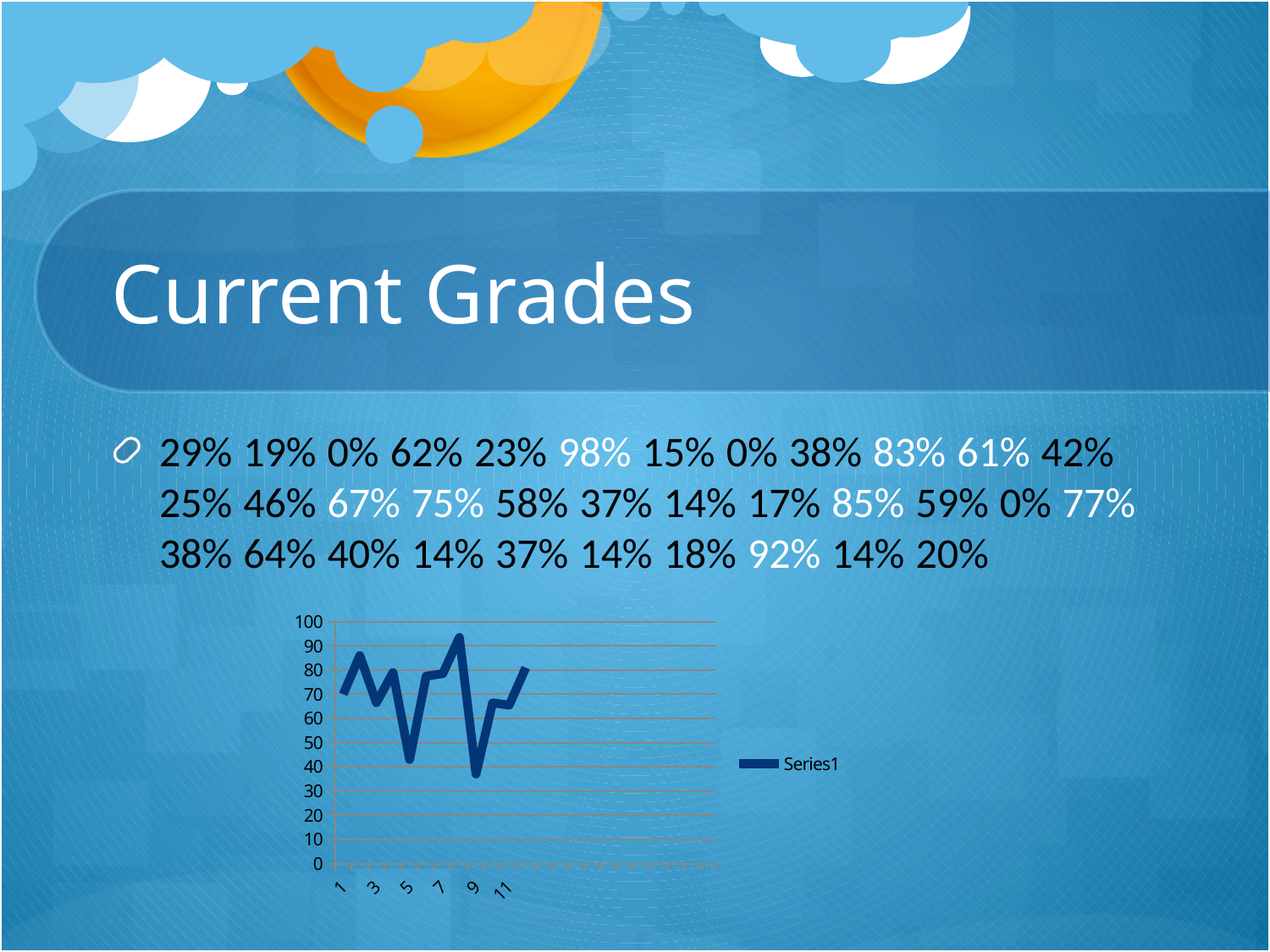
Which has the larger value on the chart, point 2 or point 4? point 2 What kind of chart is shown on the slide? line chart At which x-axis point does the line reach its highest value? 8 Is the value at point 4 on the chart greater or less than 50? greater Is the value at point 2 on the chart greater or less than 80? greater What is the name of the series shown in the chart legend? Series1 How many series does the chart's legend list? 1 Is the value at point 7 on the chart greater or less than 90? less At which x-axis point does the line reach its lowest value? 9 Does the line rise or fall between point 7 and point 8? rise What is the highest value shown on the chart's vertical axis? 100